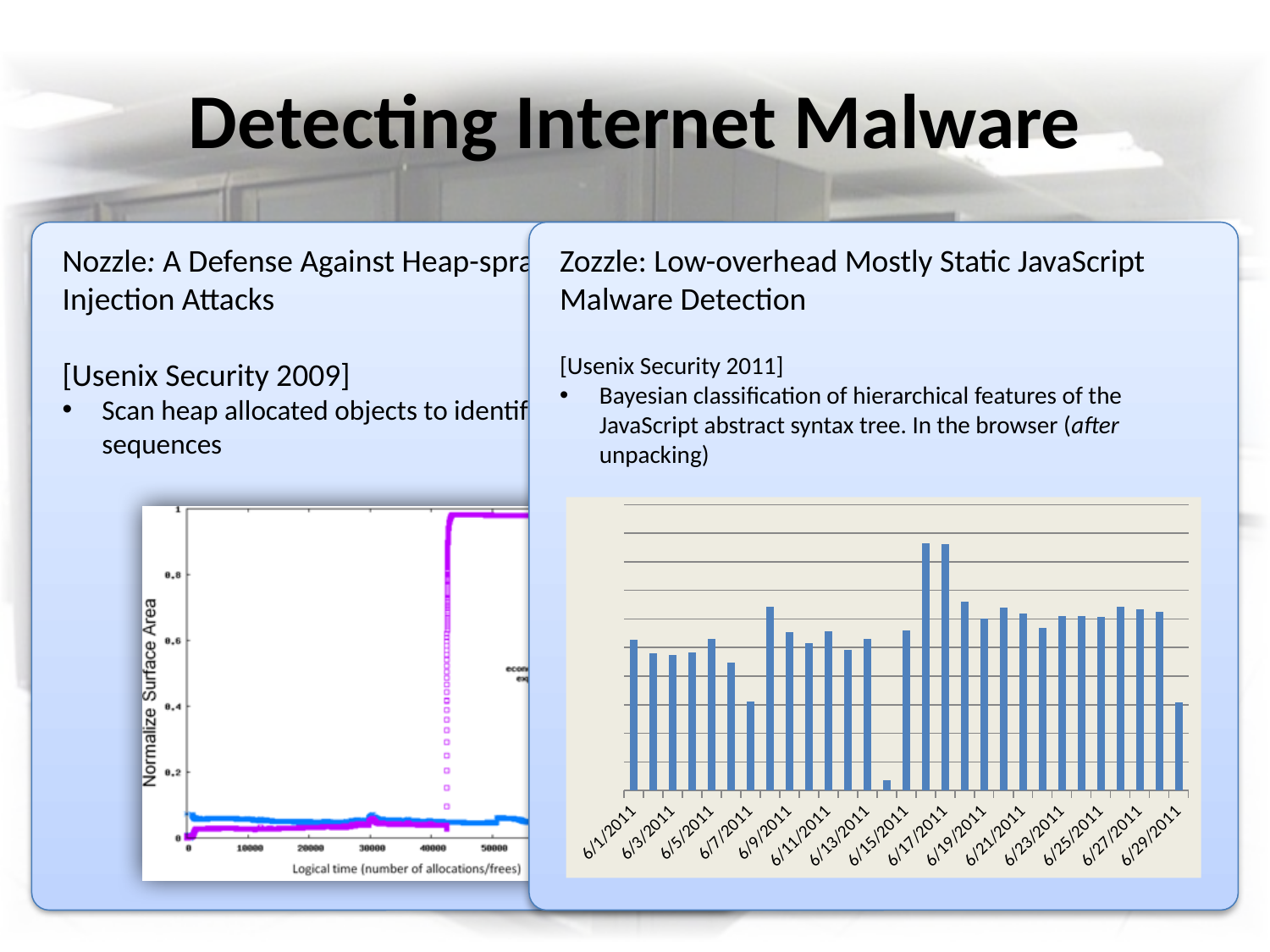
In the right-hand bar chart, what is the last date shown on the x axis? 6/29/2011 What kind of chart is shown in the Zozzle panel on the right of the slide? bar chart In the left-hand line chart, what is the label on the y axis? Normalize Surface Area In the left-hand line chart, is the magenta series at logical time 50000 greater or less than 0.8? greater What kind of chart is shown in the Nozzle panel on the left of the slide? line chart In the left-hand line chart, what is the highest tick value printed on the y axis? 1 In the left-hand line chart, is the blue series at logical time 50000 greater or less than 0.2? less In the right-hand bar chart, which is taller: the first bar (6/1/2011) or the last bar (6/29/2011)? 6/1/2011 In the right-hand bar chart, how many date labels are printed along the x axis? 15 In the left-hand line chart, does the magenta series rise or fall sharply just after logical time 40000? rise In the left-hand line chart, is the magenta series at logical time 20000 greater or less than 0.2? less